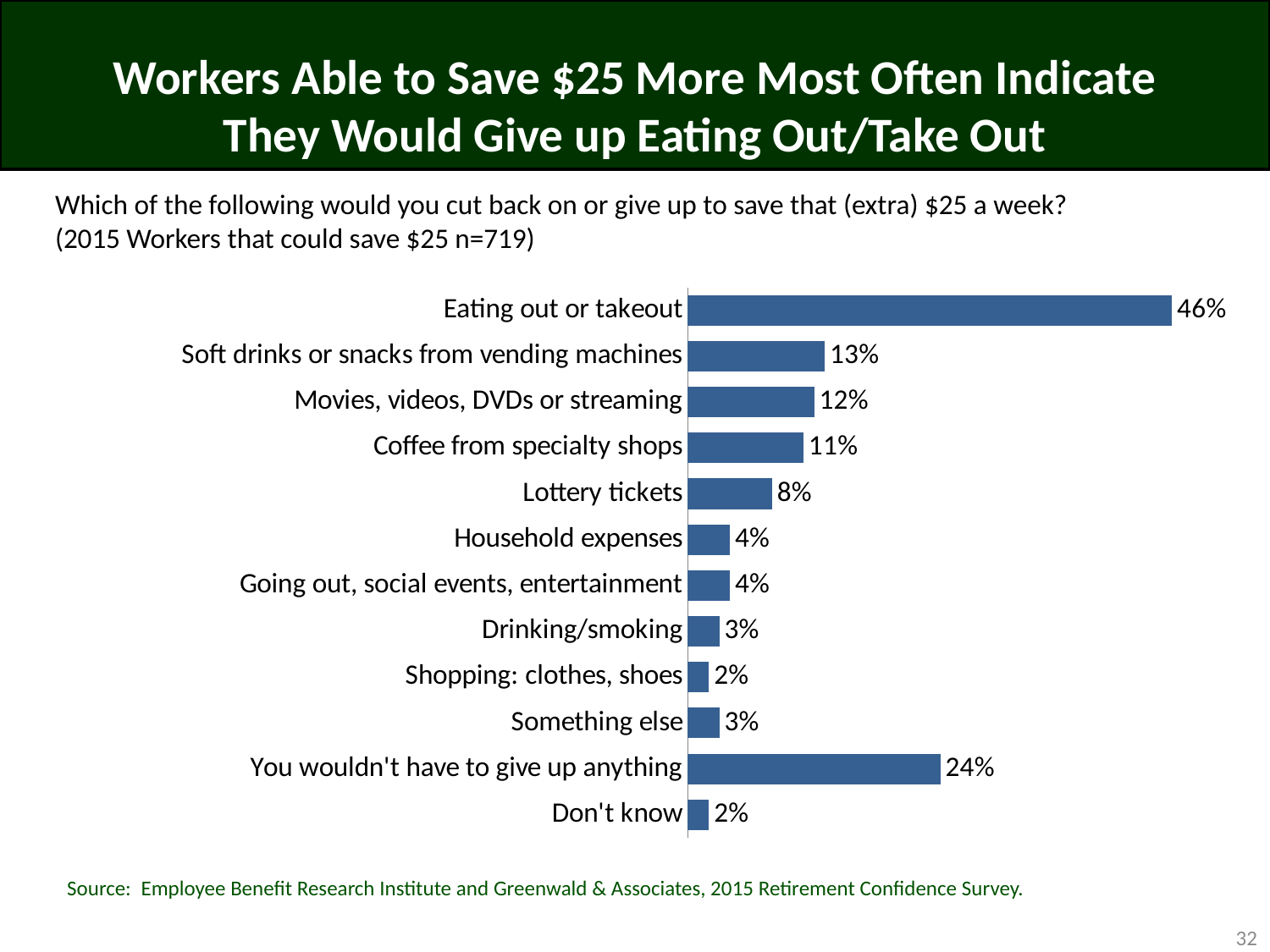
What kind of chart is shown on the slide? Bar chart What is the value for 'You wouldn't have to give up anything'? 24% What is the value for 'Drinking/smoking'? 3% Which is larger, the value for 'Lottery tickets' or the value for 'Household expenses'? Lottery tickets What is the difference between 'Eating out or takeout' and 'You wouldn't have to give up anything'? 22% What is the sample size (n) stated for the 2015 workers that could save $25? 719 What percentage would cut back on coffee from specialty shops? 11% What percentage of workers said they would give up eating out or takeout? 46% Which category has the highest value? Eating out or takeout What is the value for lottery tickets? 8% How many categories are shown in the chart? 12 What is the difference between 'Soft drinks or snacks from vending machines' and 'Movies, videos, DVDs or streaming'? 1%